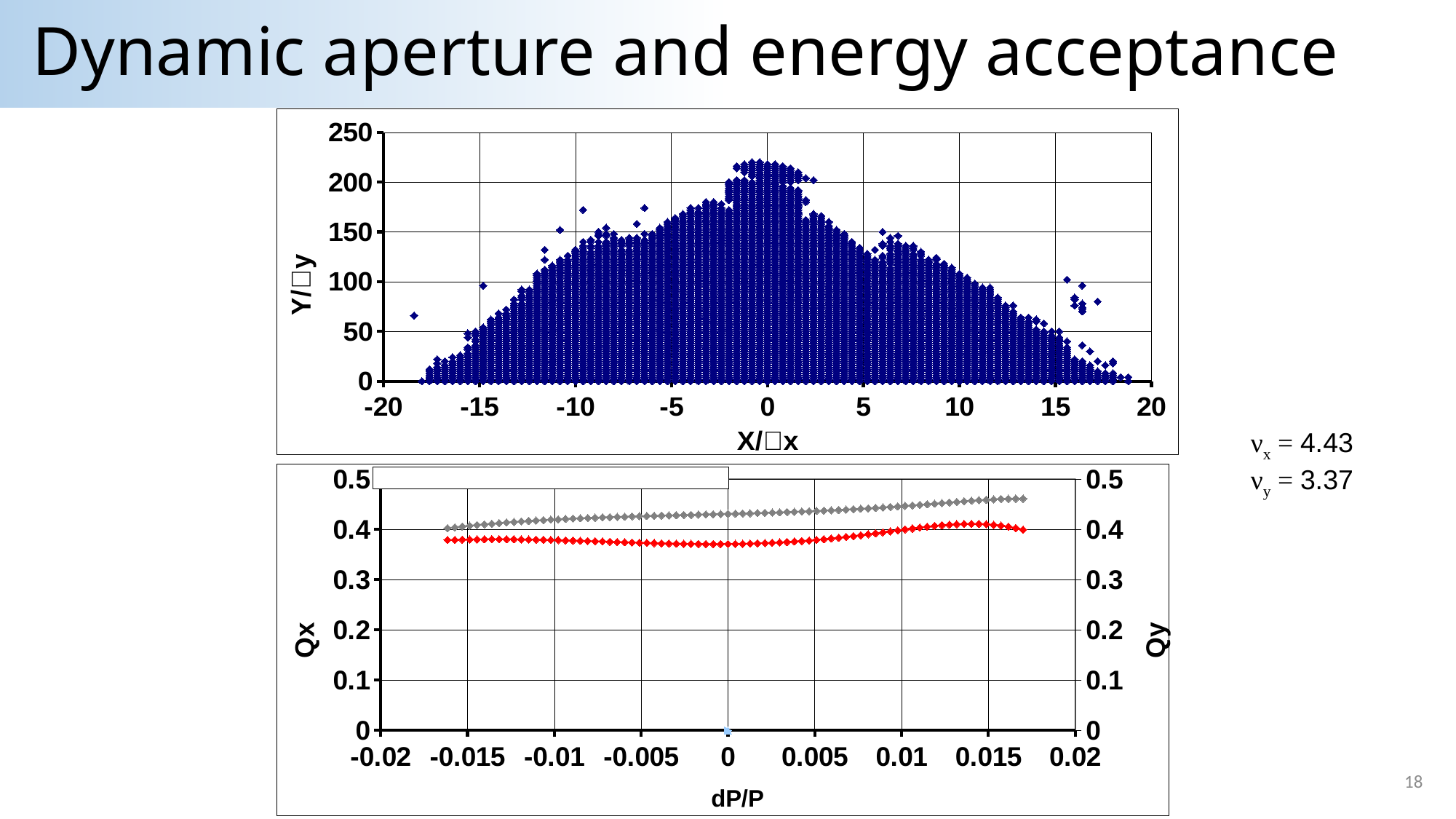
What is the label of the x axis of the bottom chart? dP/P In the top chart, is the top of the filled region at X/σx = -5 greater or less than 150? greater What kind of chart is the top chart (Y/σy versus X/σx)? scatter chart In the top chart, what range does the X/σx axis cover? -20 to 20 How many data series are plotted in the bottom chart (Qx/Qy versus dP/P)? 2 In the bottom chart, does the grey series rise or fall as dP/P increases from -0.015 to 0.015? rise In the bottom chart, which series has the higher value at dP/P = 0, the grey series or the red series? grey series In the top chart, what is the maximum value shown on the Y/σy axis? 250 In the top chart, is the top of the filled region at X/σx = 10 greater or less than 150? less In the top chart, is the highest Y/σy value reached by the plotted points greater or less than 200? greater